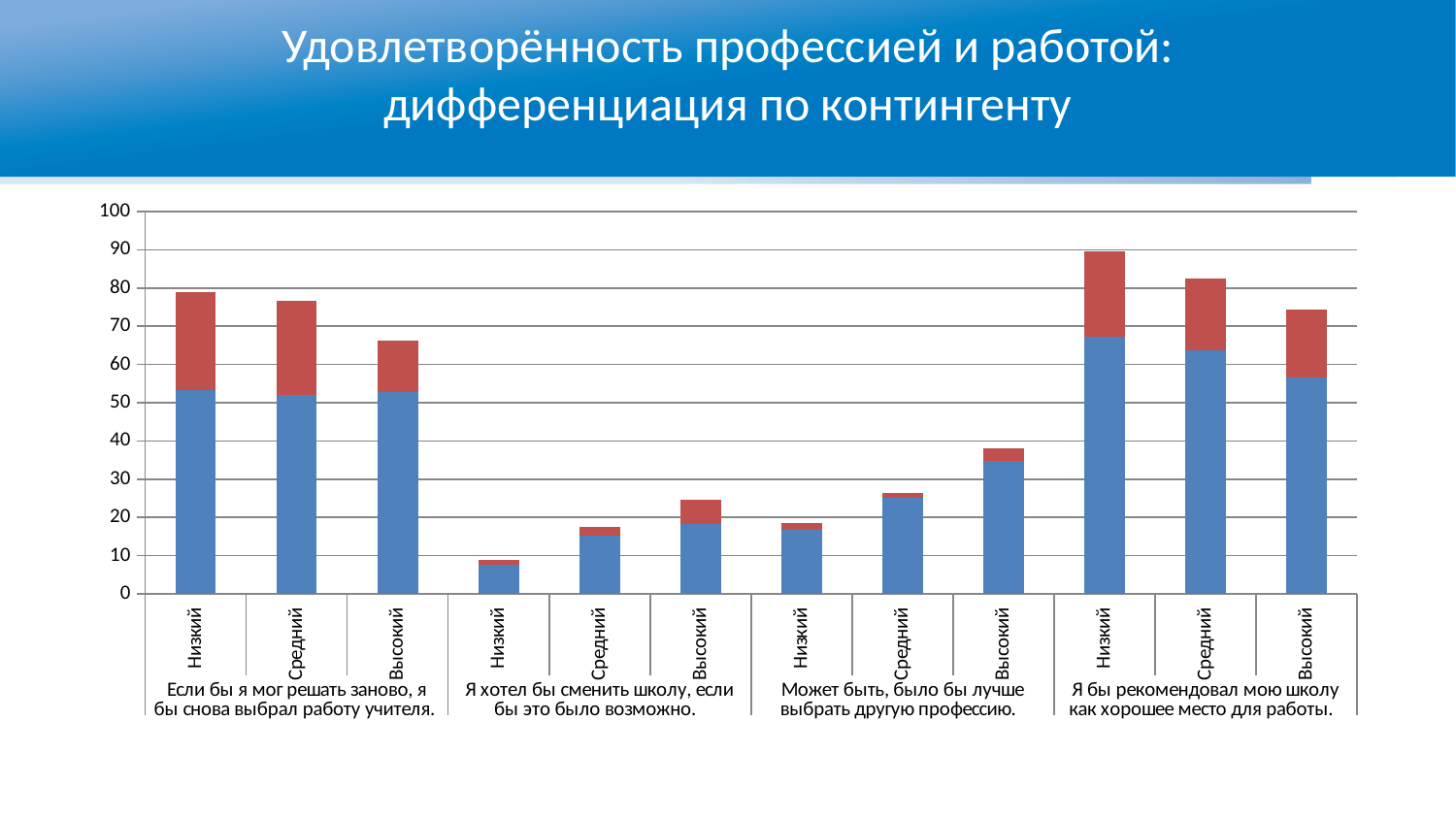
In the group «Я хотел бы сменить школу, если бы это было возможно.», do the bars rise or fall from Низкий to Высокий? rise Is the total bar for Высокий in the group «Если бы я мог решать заново, я бы снова выбрал работу учителя.» greater or less than 60? greater Is the total bar for Низкий in the group «Я хотел бы сменить школу, если бы это было возможно.» greater or less than 10? less In the group «Я бы рекомендовал мою школу как хорошее место для работы.», which bar is taller: Низкий or Средний? Низкий What kind of chart is shown on the slide? Stacked bar chart Which bar is the shortest in the chart? Низкий in the group «Я хотел бы сменить школу, если бы это было возможно.» Is the total bar for Высокий in the group «Может быть, было бы лучше выбрать другую профессию.» greater or less than 40? less What is the title of the slide? Удовлетворённость профессией и работой: дифференциация по контингенту Which bar is the tallest in the chart? Низкий in the group «Я бы рекомендовал мою школу как хорошее место для работы.» How many statement groups are shown along the x axis? 4 How many bars are plotted in the chart? 12